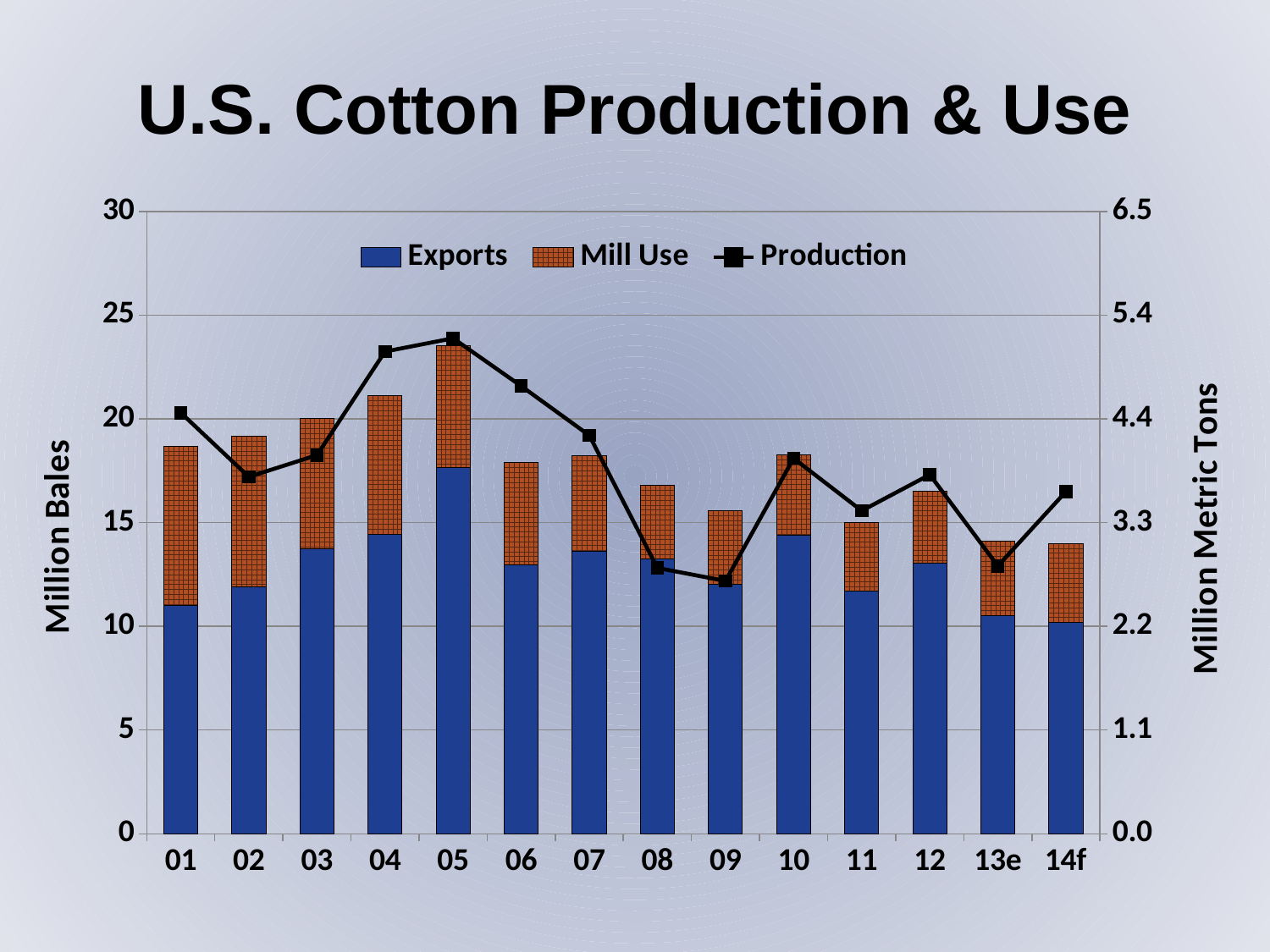
Which year has the highest Production value? 05 Is the Exports value for 05 greater or less than 15 million bales? greater How many series does the legend list? 3 How many years are shown along the x axis? 14 Is the Production value for 04 greater or less than 4.4 million metric tons? greater Does Production rise or fall from 05 to 09? fall Which year has the tallest stacked bar (Exports plus Mill Use)? 05 Is the Production value for 08 greater or less than 3.3 million metric tons? less Which is larger, the Exports value for 05 or for 01? 05 What kind of chart is shown on the slide? A combined bar and line chart (stacked bars with a line) Which year has the highest Exports value? 05